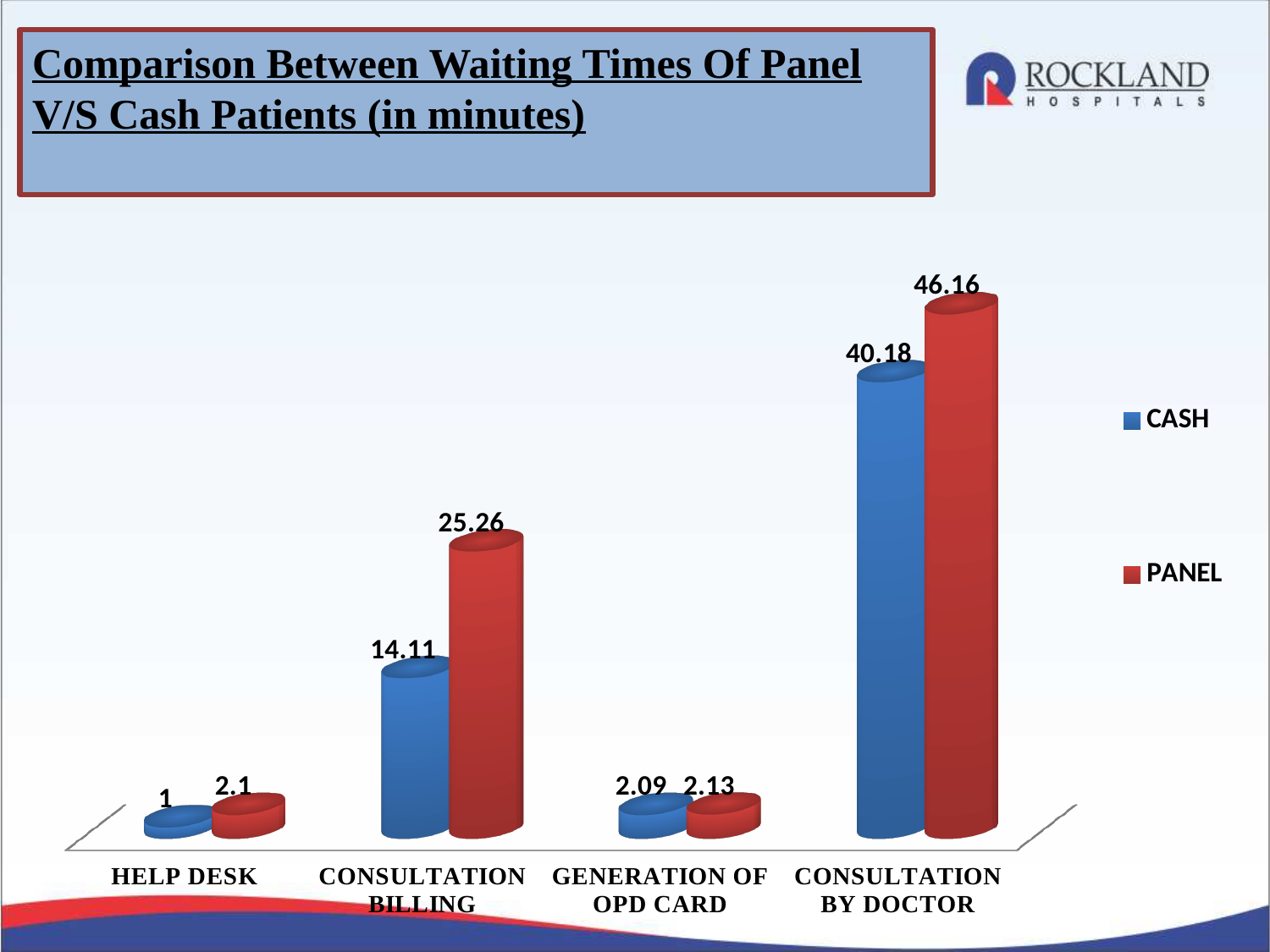
What is the difference between the PANEL and CASH waiting times for CONSULTATION BY DOCTOR? 5.98 What kind of chart is shown on the slide? Bar chart What is the PANEL waiting time for GENERATION OF OPD CARD? 2.13 How many categories are shown on the x axis? 4 Which category has the highest PANEL waiting time? CONSULTATION BY DOCTOR Which is larger for CONSULTATION BILLING, the CASH or the PANEL waiting time? PANEL What is the difference between the PANEL and CASH waiting times for CONSULTATION BILLING? 11.15 Which category has the lowest CASH waiting time? HELP DESK How many series does the legend list? 2 What is the CASH waiting time for HELP DESK? 1 What is the CASH waiting time for CONSULTATION BY DOCTOR? 40.18 What is the PANEL waiting time for CONSULTATION BILLING? 25.26